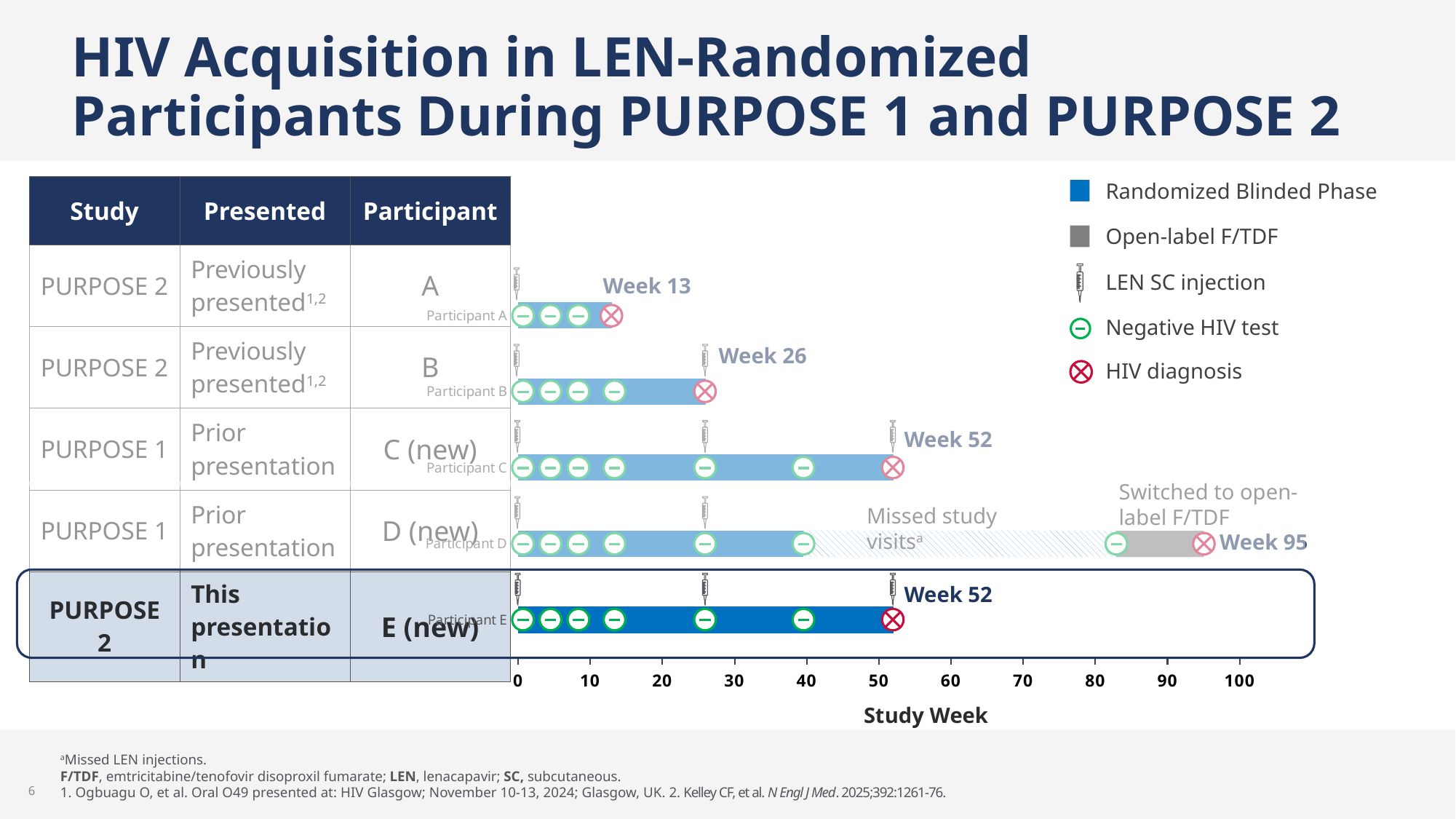
Which participant had the earliest HIV diagnosis on the timeline? Participant A What is the label of the x axis of the timeline chart? Study Week At which study week was Participant A diagnosed with HIV? Week 13 At which study week was Participant D diagnosed with HIV? Week 95 At which study week was Participant E diagnosed with HIV? Week 52 Which participant was diagnosed with HIV later, Participant A or Participant B? Participant B Which participant had the latest HIV diagnosis on the timeline? Participant D How many participants are shown on the timeline chart? 5 Which participant switched to open-label F/TDF before HIV diagnosis? Participant D At which study week was Participant B diagnosed with HIV? Week 26 How many weeks later was Participant D's HIV diagnosis than Participant A's? 82 weeks Is Participant D's HIV diagnosis week greater or less than 90? greater